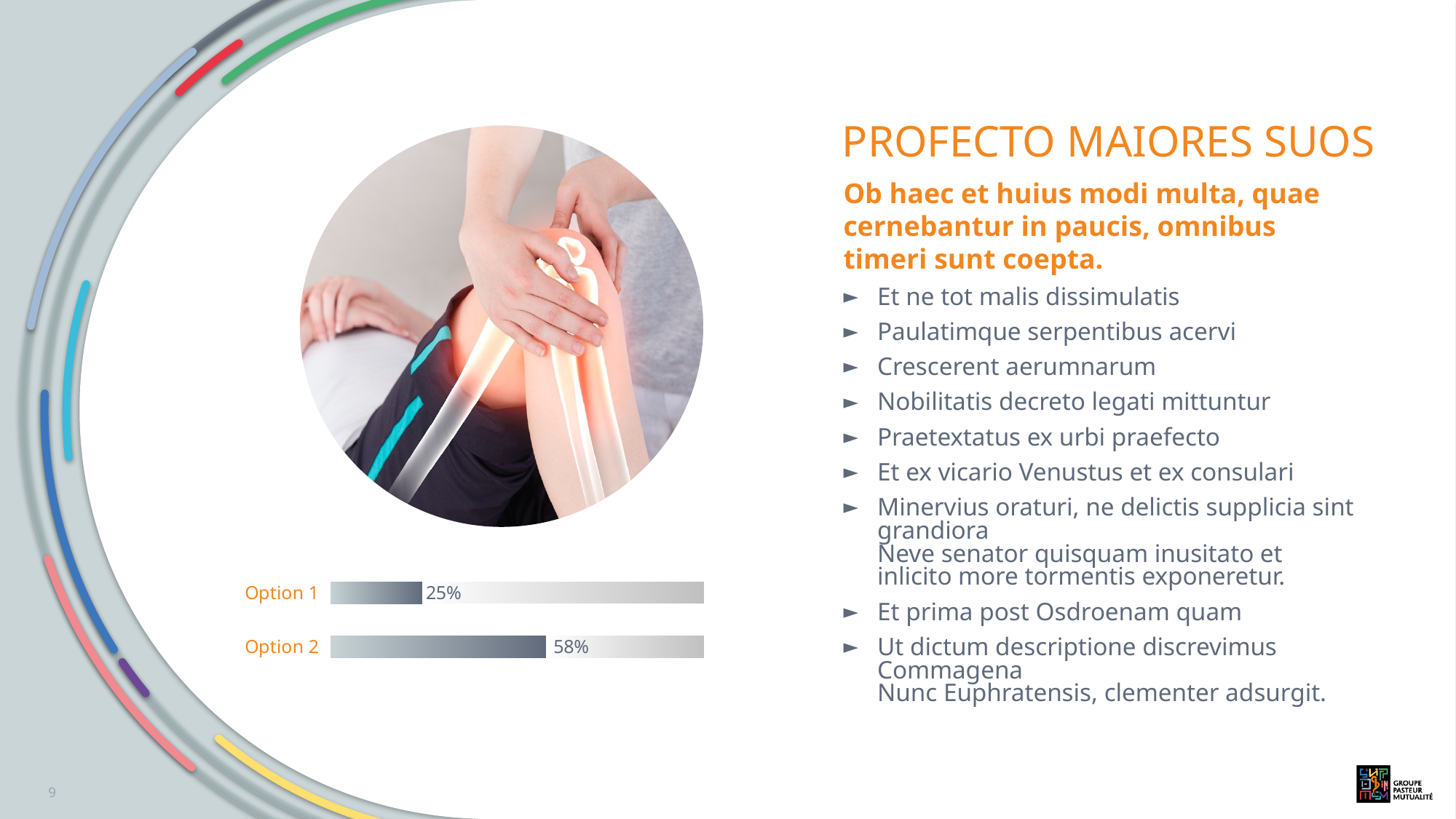
What kind of chart is shown on the slide? Bar chart Which option has the highest value? Option 2 Are the bars in the chart horizontal or vertical? Horizontal What is the total of the values for Option 1 and Option 2? 83% How many options are shown in the chart? 2 What is the value for Option 1? 25% What is the value for Option 2? 58% Which is larger, the value for Option 1 or the value for Option 2? Option 2 Which option has the lowest value? Option 1 What is the difference between the values for Option 2 and Option 1? 33%